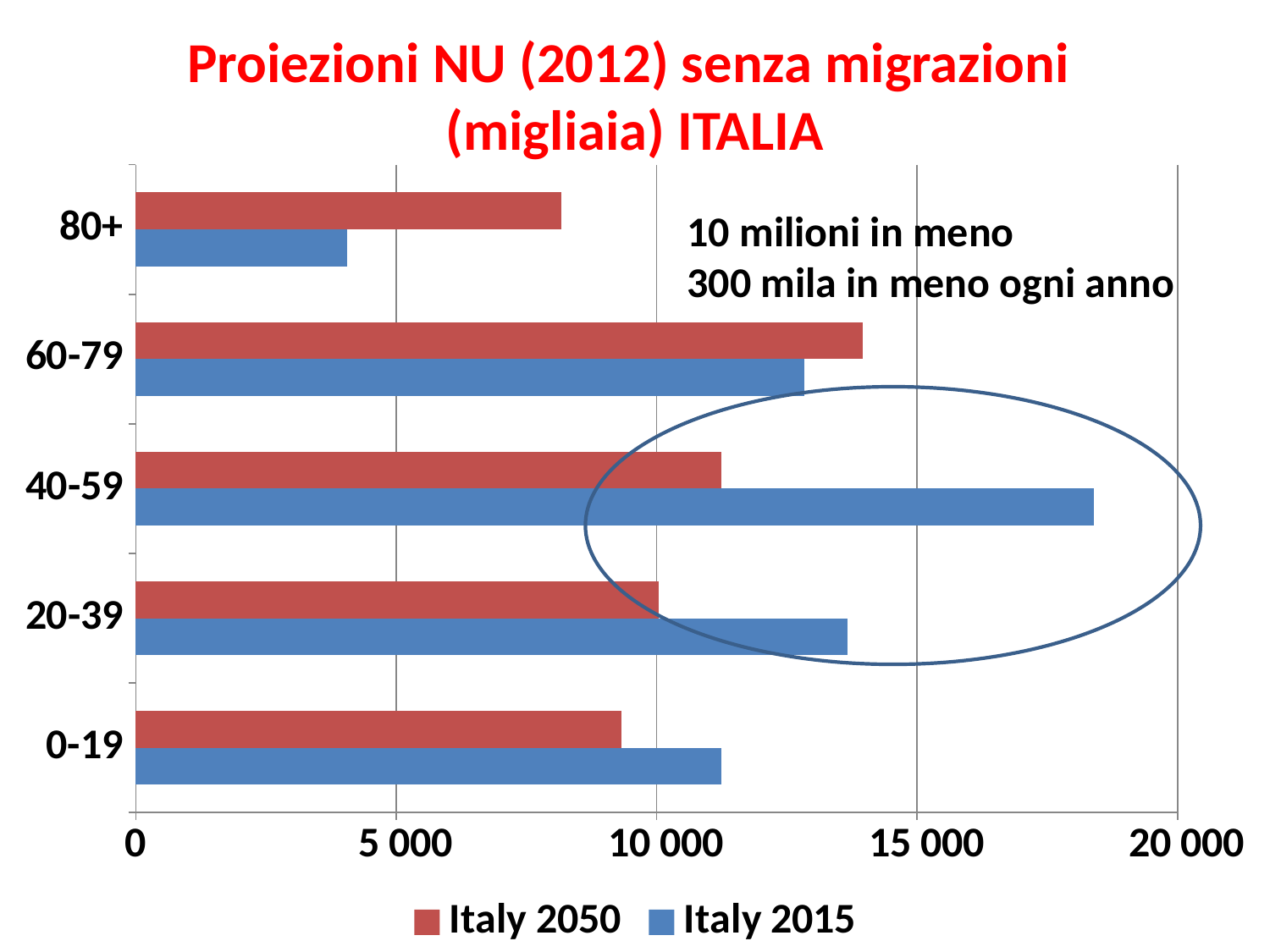
For the 40-59 age group, which series has the larger value, Italy 2050 or Italy 2015? Italy 2015 Which age group has the highest value for Italy 2015? 40-59 What kind of chart is shown on the slide? bar chart Is the Italy 2015 value for the 40-59 age group greater or less than 15 000? greater Which colour represents the Italy 2050 series in the legend? red Which age group has the highest value for Italy 2050? 60-79 Which age group has the lowest value for Italy 2015? 80+ For the 80+ age group, which series has the larger value, Italy 2050 or Italy 2015? Italy 2050 Is the Italy 2015 value for the 80+ age group greater or less than 5 000? less How many age groups are shown on the vertical axis? 5 Which age group has the lowest value for Italy 2050? 80+ How many series does the legend list? 2